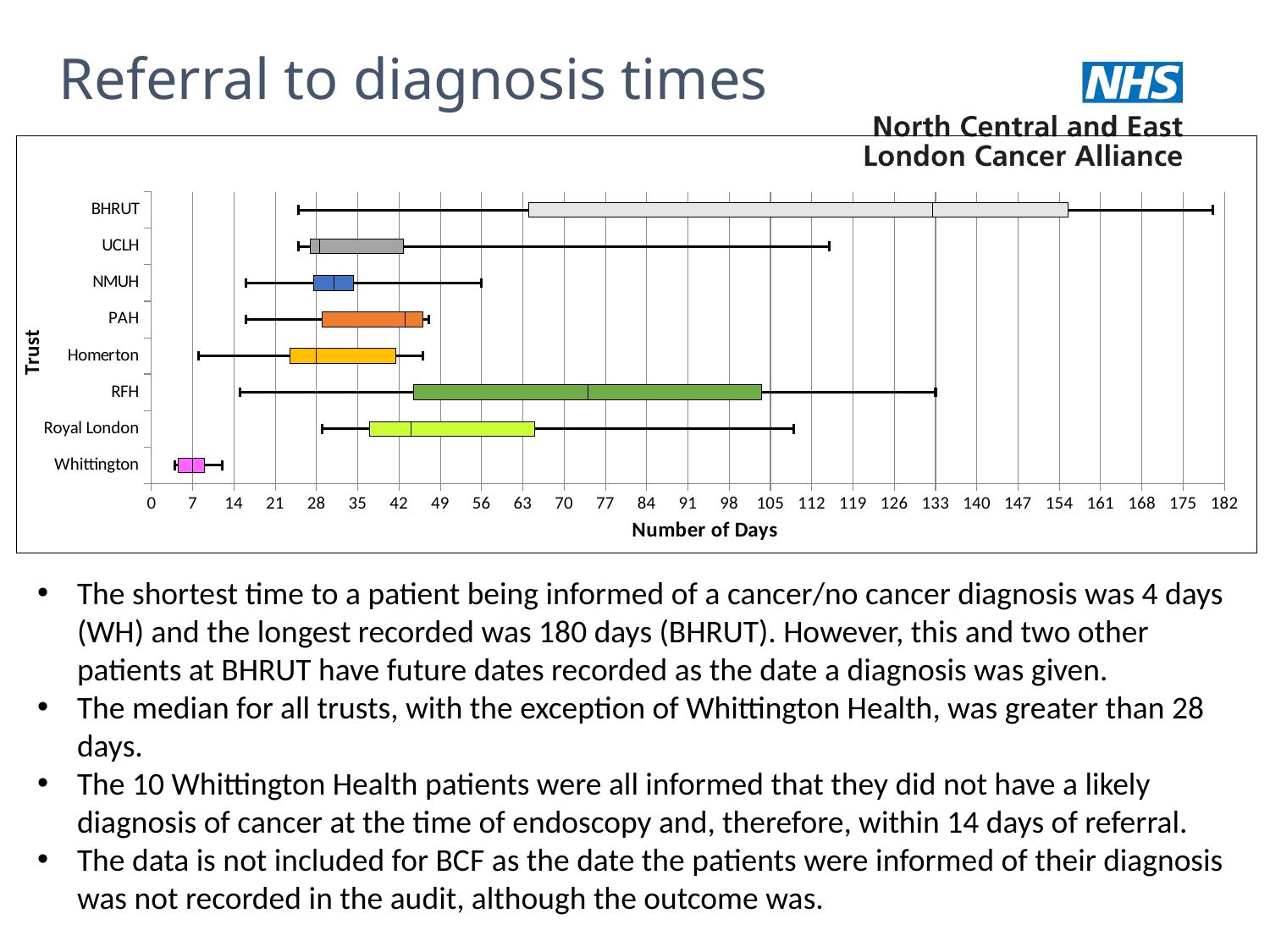
Is the maximum value for PAH greater or less than 56 days? less Is the maximum value for BHRUT greater or less than 175 days? greater Which trust has the shortest maximum referral to diagnosis time? Whittington What kind of chart is shown on the slide? Box-and-whisker chart What is the title of the vertical axis? Trust Is the median for Whittington greater or less than 14 days? less How many trusts are plotted on the chart? 8 Which trust has the higher median, RFH or NMUH? RFH Which trust has the widest interquartile box? BHRUT What is the title of the horizontal axis? Number of Days Which trust has the longest maximum referral to diagnosis time (whisker extending furthest right)? BHRUT